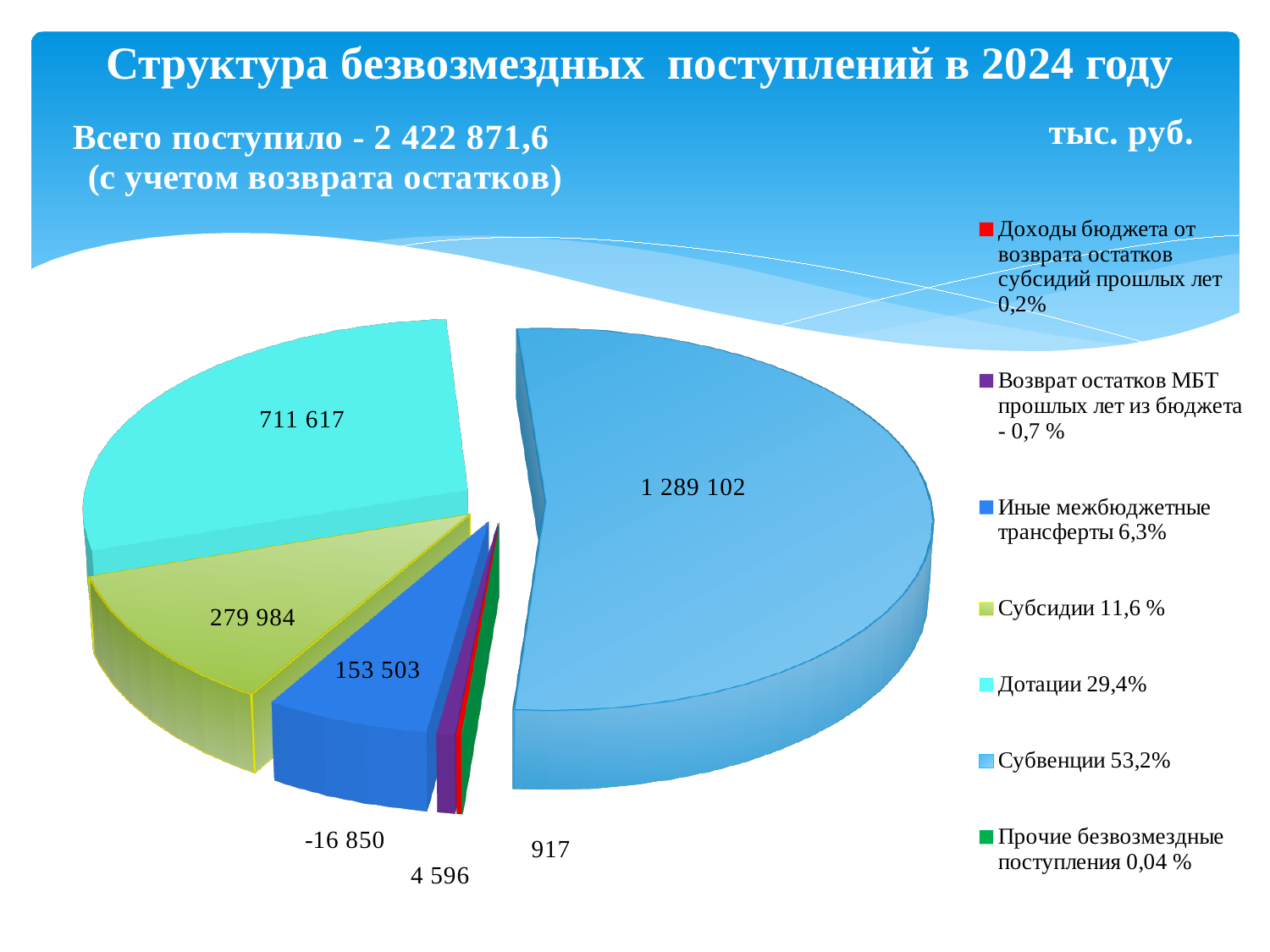
What is the value for Субвенции? 1 289 102 Which category has the largest slice of the pie? Субвенции What is the title of the chart? Всего поступило - 2 422 871,6 (с учетом возврата остатков) Which is larger, the value for Субсидии or the value for Иные межбюджетные трансферты? Субсидии What is the value for Иные межбюджетные трансферты? 153 503 What is the difference between the values for Субвенции and Дотации? 577 485 What share of the pie does Дотации represent, according to the legend? 29,4% What is the value for Субсидии? 279 984 What is the value for Дотации? 711 617 What share of the pie does Субсидии represent, according to the legend? 11,6 % What type of chart is shown on the slide? pie chart How many categories does the legend list? 7